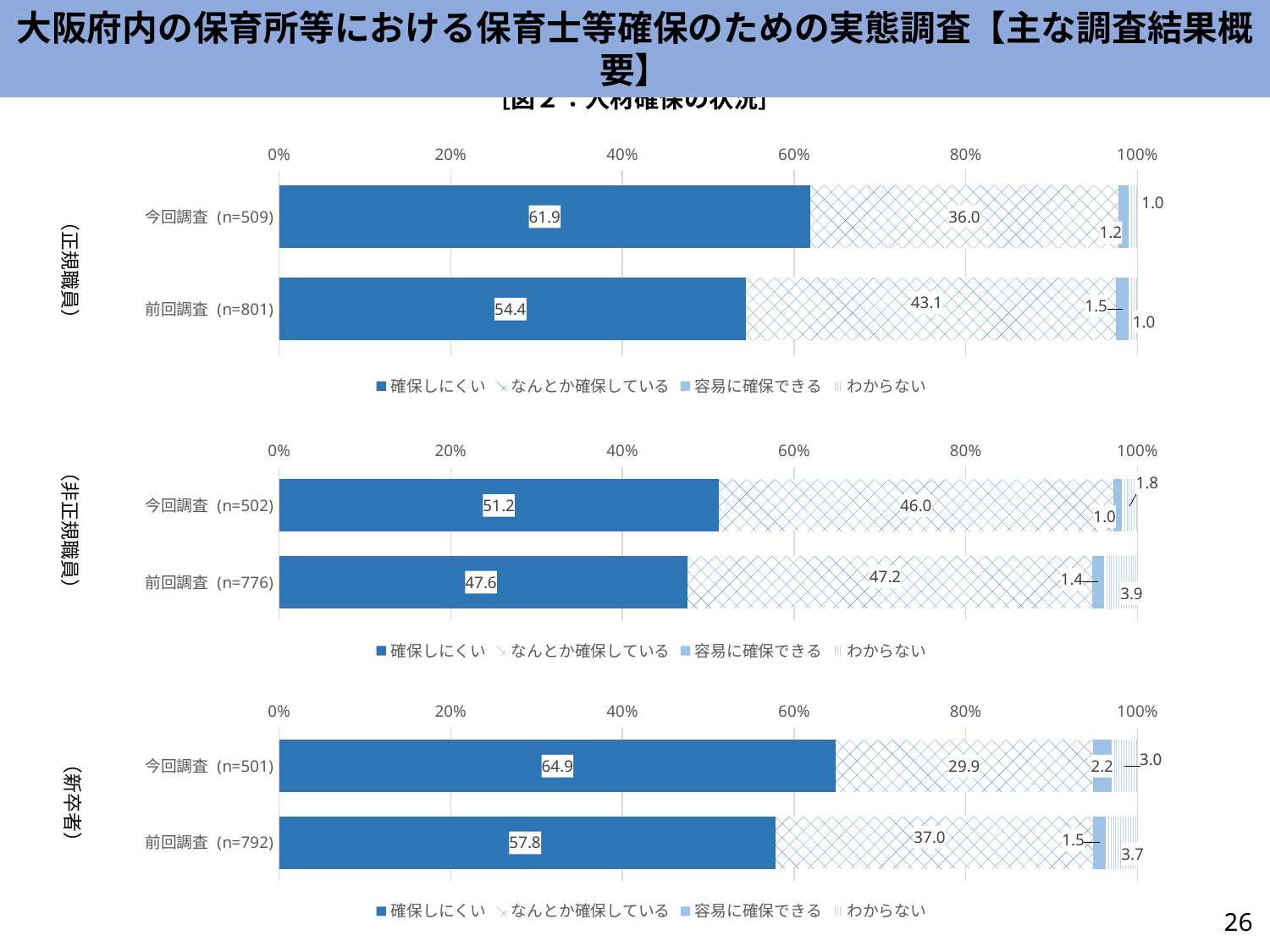
In the bottom chart (新卒者), what is the value of 確保しにくい for 今回調査 (n=501)? 64.9 How many categories (bars) are shown in the bottom chart (新卒者)? 2 In the top chart (正規職員), what is the value of 確保しにくい for 今回調査 (n=509)? 61.9 How many series does the legend of the top chart (正規職員) list? 4 What kind of chart is the middle chart (非正規職員)? Stacked bar chart In the bottom chart (新卒者), what is the difference in なんとか確保している between 前回調査 (n=792) and 今回調査 (n=501)? 7.1 In the middle chart (非正規職員), what is the value of わからない for 前回調査 (n=776)? 3.9 In the middle chart (非正規職員), what is the value of 容易に確保できる for 今回調査 (n=502)? 1.0 In the top chart (正規職員), what is the difference in 確保しにくい between 今回調査 (n=509) and 前回調査 (n=801)? 7.5 In the middle chart (非正規職員), which is larger for 前回調査 (n=776): 確保しにくい or なんとか確保している? 確保しにくい In the bottom chart (新卒者), is the value of 確保しにくい for 前回調査 (n=792) greater or less than 60%? less In the top chart (正規職員), what is the value of なんとか確保している for 前回調査 (n=801)? 43.1